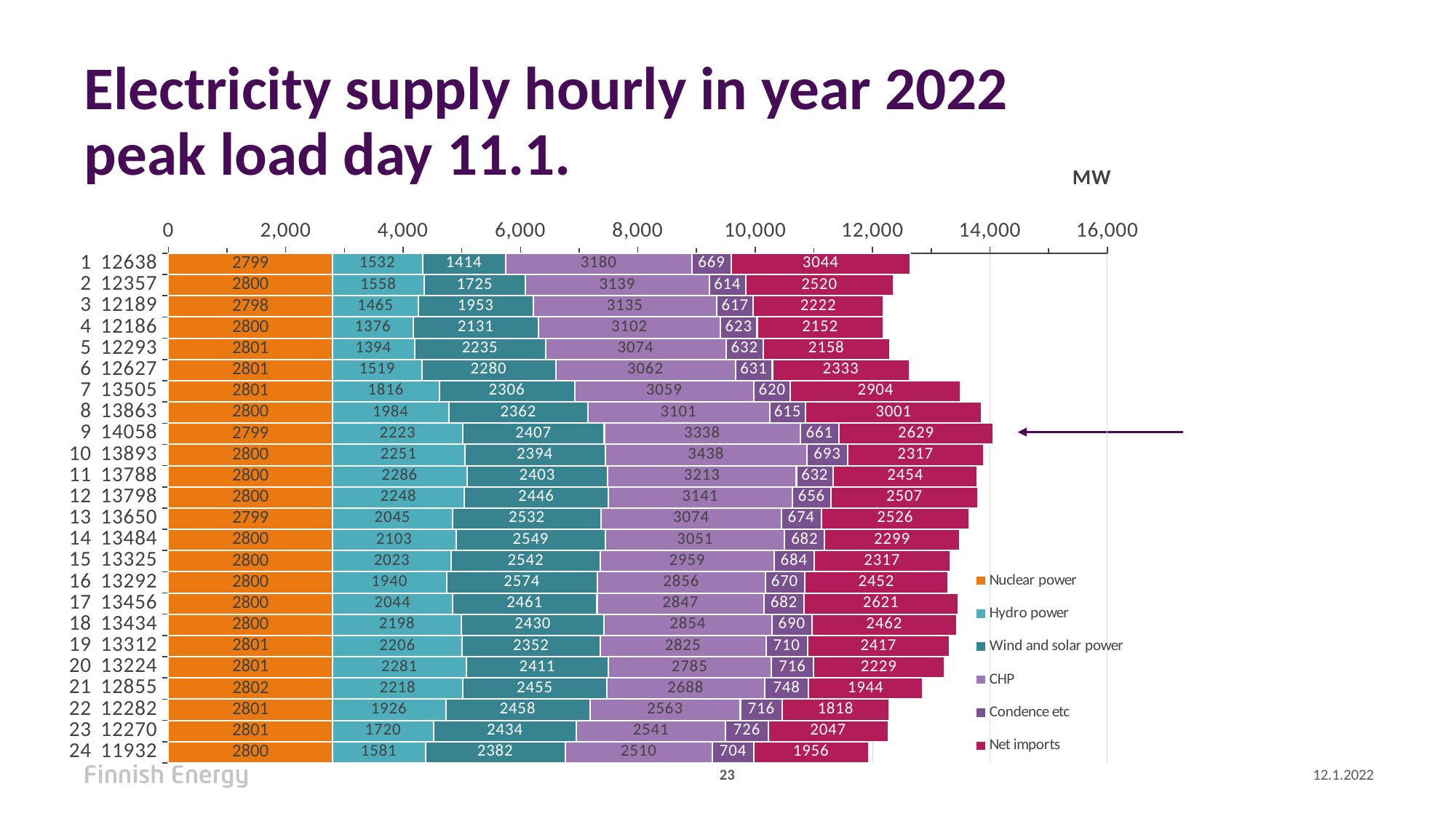
Is the Hydro power value larger at hour 11 or at hour 12? hour 11 What is the Hydro power value for hour 9? 2223 How many series does the legend list? 6 What is the Condence etc value for hour 21? 748 Which hour has the highest total electricity supply? 9 What is the Net imports value for hour 1? 3044 What is the total of the stacked bar for hour 9? 14058 Which hour has the lowest total electricity supply? 24 Is the total supply for hour 9 greater or less than 14,000? greater How many hours (categories) are plotted in the chart? 24 What is the CHP value for hour 10? 3438 What is the difference between the Net imports values for hour 1 and hour 2? 524